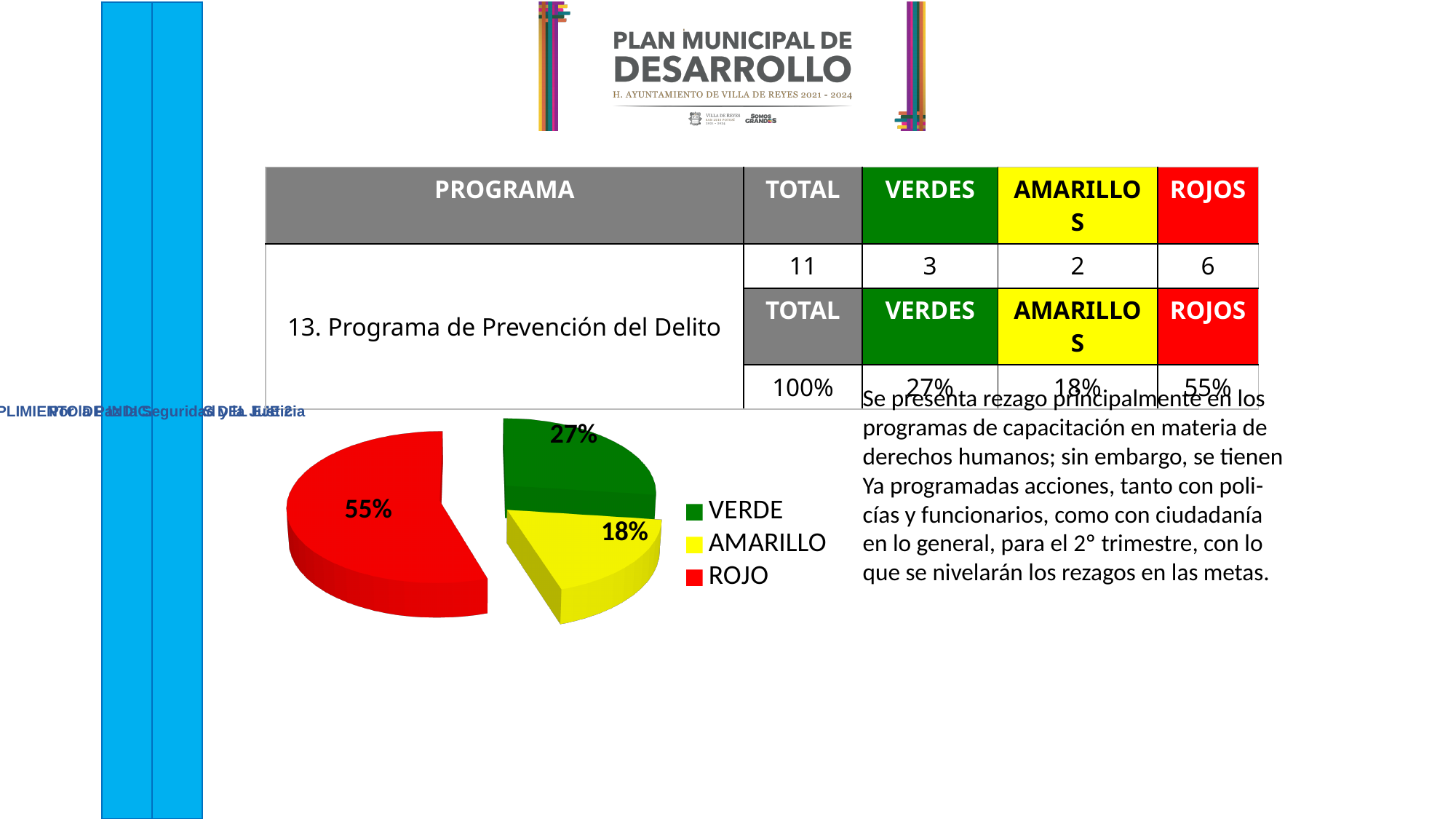
Which slice of the pie chart is the largest? ROJO What share of the pie does the AMARILLO slice represent? 18% How many slices does the pie chart have? 3 What are the legend entries of the pie chart, from top to bottom? VERDE, AMARILLO, ROJO What kind of chart is shown on the slide? pie chart What is the difference in percentage points between the ROJO slice and the VERDE slice? 28 How many entries does the pie chart legend list? 3 Which is larger in the pie chart, the VERDE slice or the AMARILLO slice? VERDE What share of the pie does the ROJO slice represent? 55% What colour is the ROJO slice in the pie chart? red Which slice of the pie chart is the smallest? AMARILLO What share of the pie does the VERDE slice represent? 27%